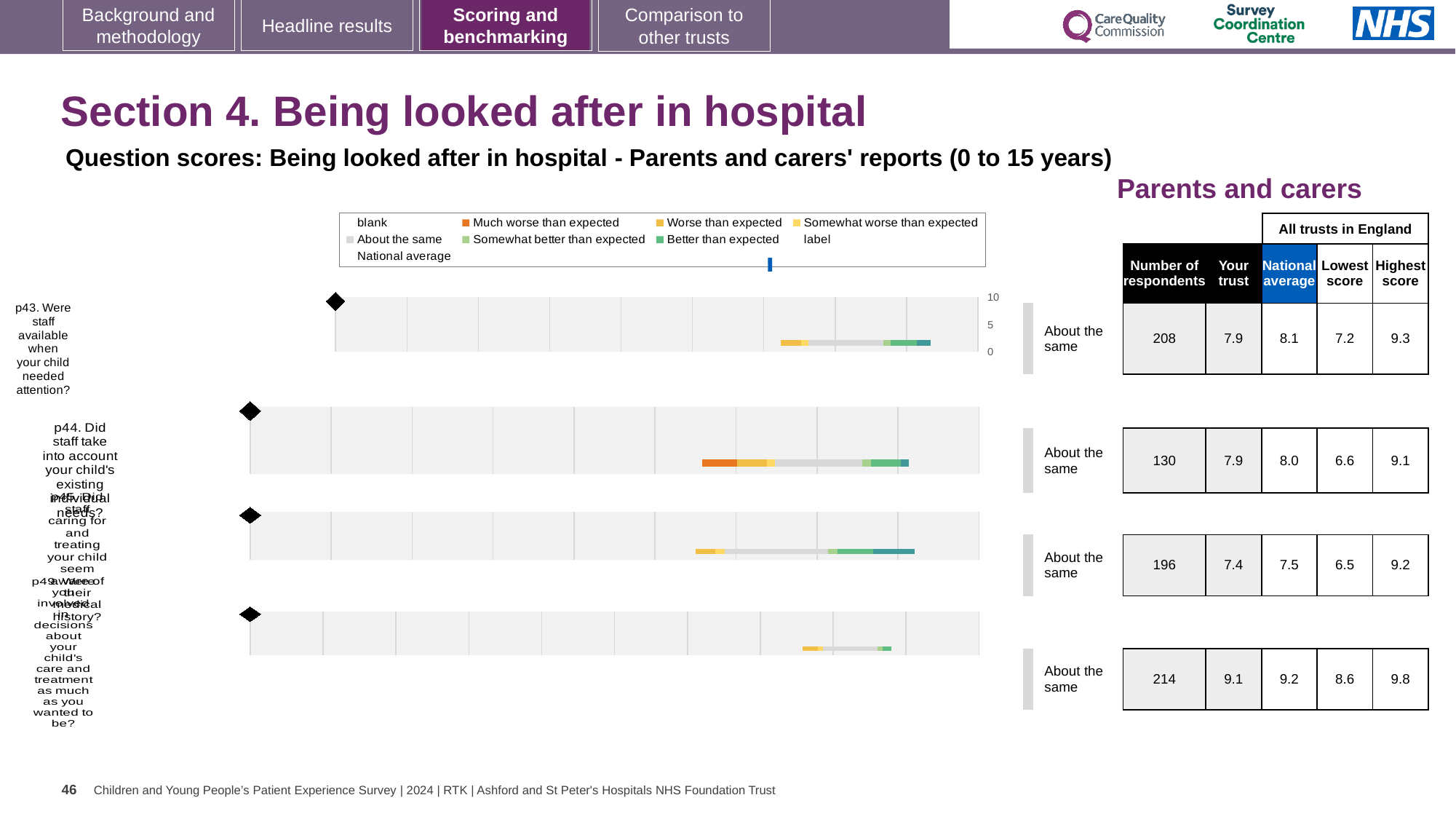
What type of chart is used to show the question scores on this slide? Bar chart What is the lowest score among all trusts in England shown for question p45? 6.5 How many respondents are shown for question p49 (Were you involved in decisions about your child's care and treatment as much as you wanted to be?)? 214 For question p43 (Were staff available when your child needed attention?), what is the 'Your trust' score shown? 7.9 What is the national average score shown for question p45 (Did staff caring for and treating your child seem aware of their medical history?)? 7.5 Which question on the slide has the largest number of respondents? p49 What is the highest score among all trusts in England shown for question p44? 9.1 Which question on the slide has the lowest 'Your trust' score? p45 For question p43, what is the difference between the highest score (9.3) and the lowest score (7.2) across all trusts in England? 2.1 How many survey questions are plotted on this slide? 4 What benchmark category is shown for every question on this slide? About the same For question p49, is the 'Your trust' score or the national average score higher? National average